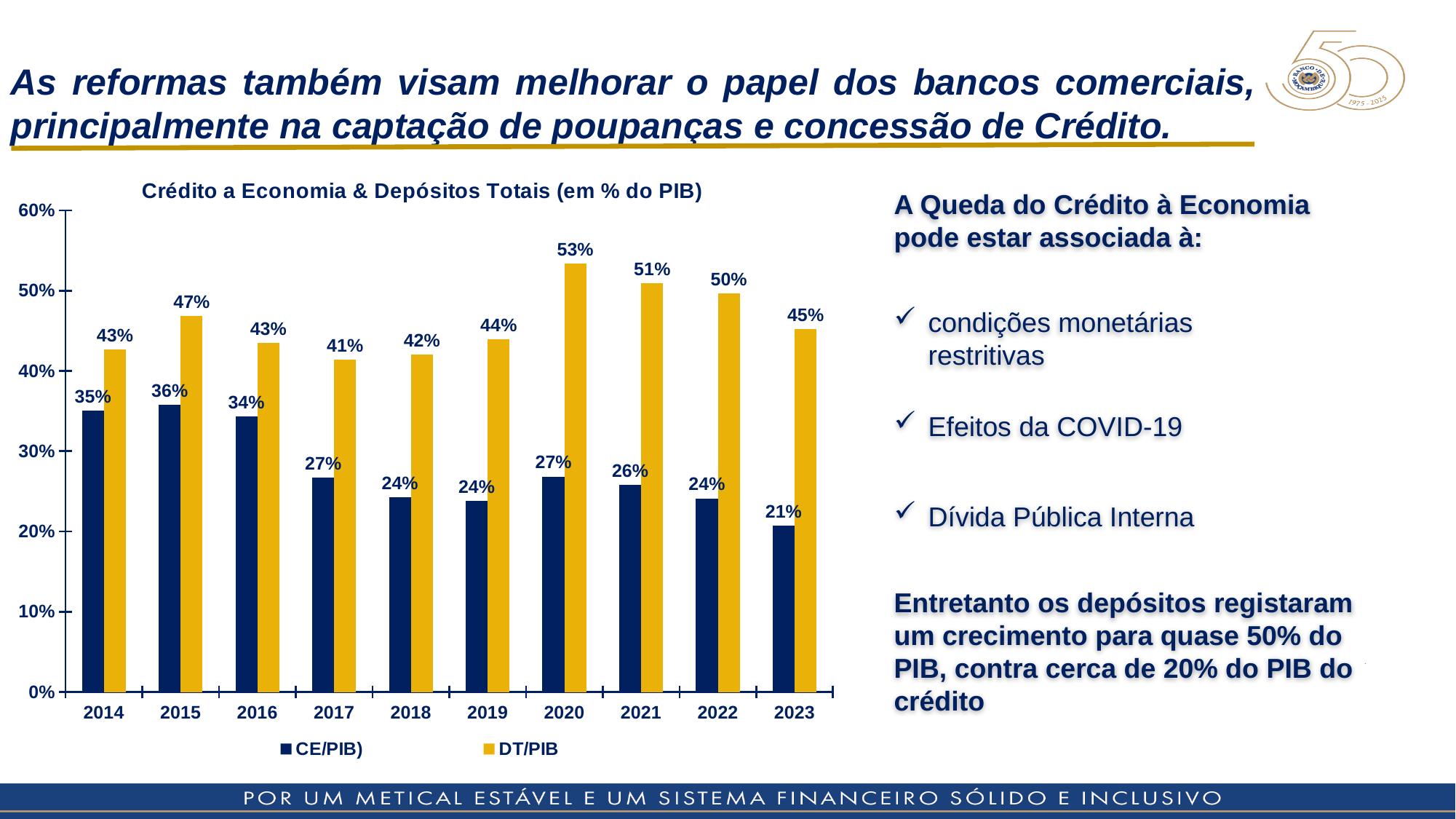
In which year is CE/PIB lowest? 2023 How many years are shown on the x axis? 10 What is the difference between DT/PIB and CE/PIB in 2023? 24 percentage points What is the DT/PIB value for 2020? 53% What is the CE/PIB value for 2023? 21% What kind of chart is shown on the slide? Bar chart In which year is CE/PIB highest? 2015 How many series does the legend list? 2 In which year is DT/PIB highest? 2020 Which is larger in 2017, CE/PIB or DT/PIB? DT/PIB What is the title of the chart? Crédito a Economia & Depósitos Totais (em % do PIB) What is the CE/PIB value for 2014? 35%